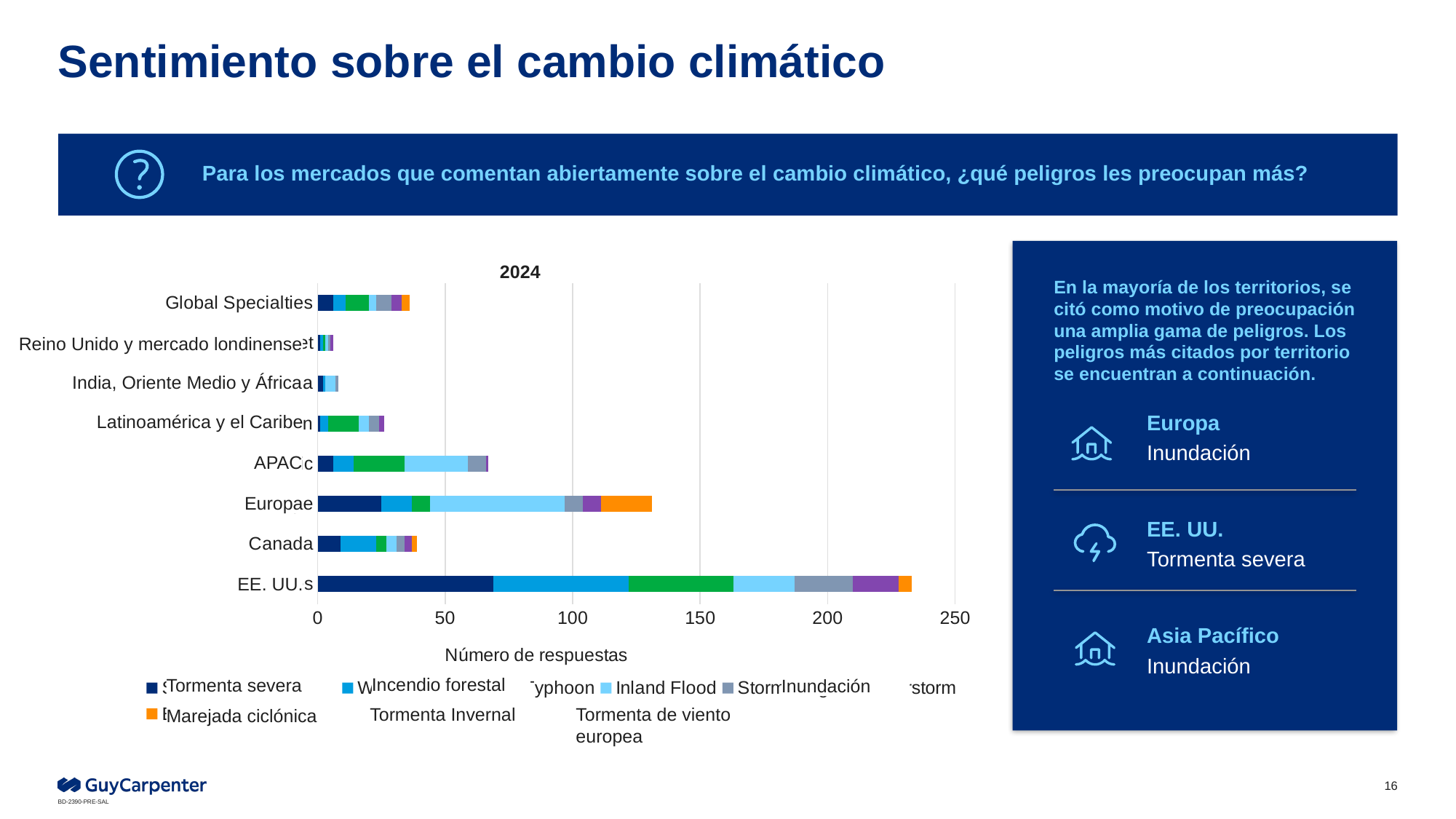
Which has the longer total bar, Europa or APAC? Europa What kind of chart is shown on the slide? Stacked bar chart What is the label of the x axis of the chart? Número de respuestas Is the total bar for EE. UU. greater or less than 200? greater How many categories (regions) are plotted on the chart? 8 Is the total bar for Canada greater or less than 50? less Is the total bar for Europa greater or less than 150? less Which category has the longest total bar? EE. UU. Which has the longer total bar, Canada or Latinoamérica y el Caribe? Canada